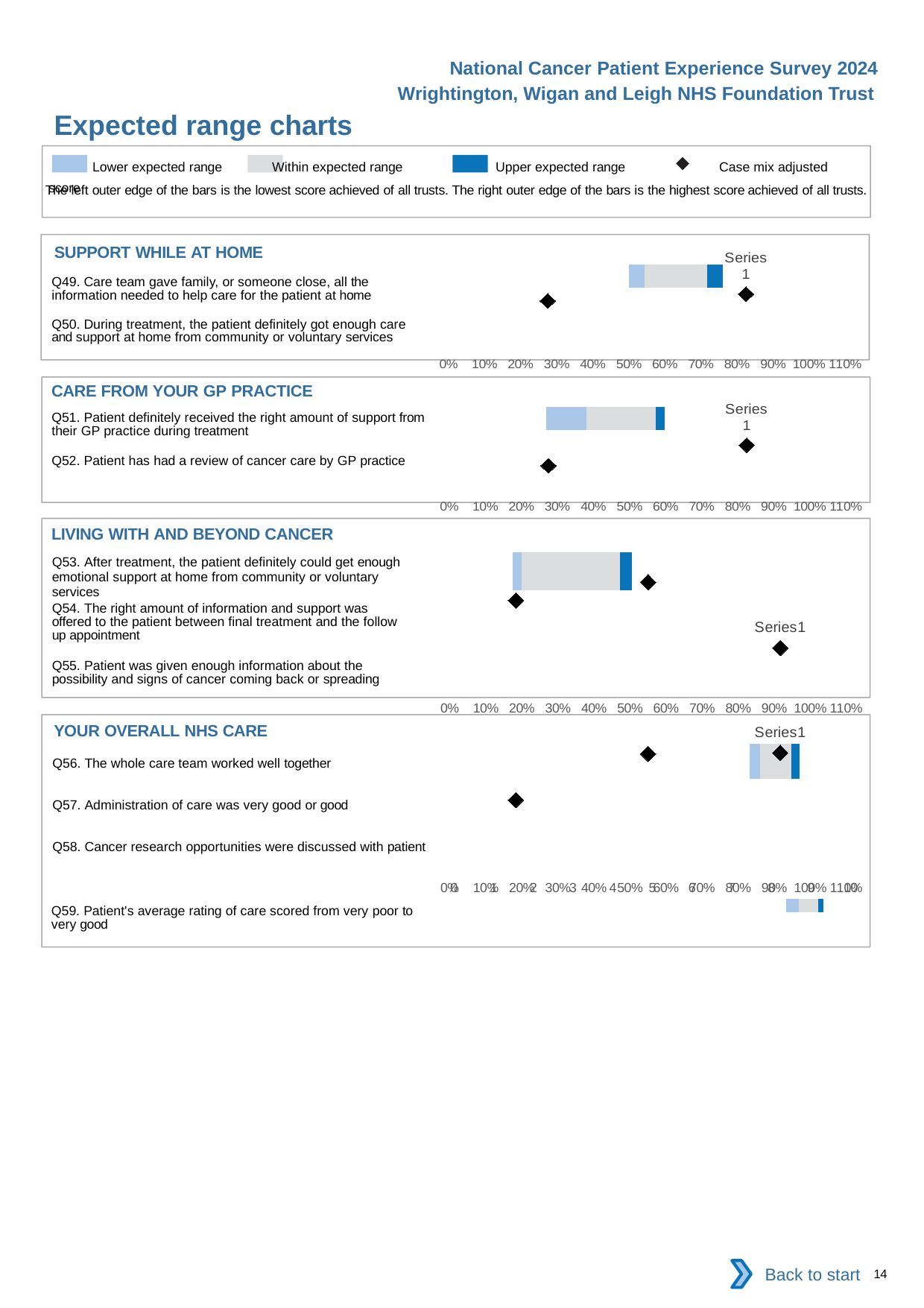
What is the highest tick label on the x axis of the CARE FROM YOUR GP PRACTICE chart? 110% In the LIVING WITH AND BEYOND CANCER chart, is the left edge of the expected range bar greater or less than 30%? less In the YOUR OVERALL NHS CARE chart, is the left edge of the expected range bar greater or less than 70%? greater In the CARE FROM YOUR GP PRACTICE chart, is the right edge of the expected range bar greater or less than 70%? less How many legend entries are shown at the top of the slide for the expected range charts? 4 How many questions are listed in the CARE FROM YOUR GP PRACTICE section? 2 Which legend entry is shown in dark blue? Upper expected range How many questions are listed in the YOUR OVERALL NHS CARE section? 4 How many questions are listed in the LIVING WITH AND BEYOND CANCER section? 3 What kind of chart is used in the SUPPORT WHILE AT HOME section? Bar chart